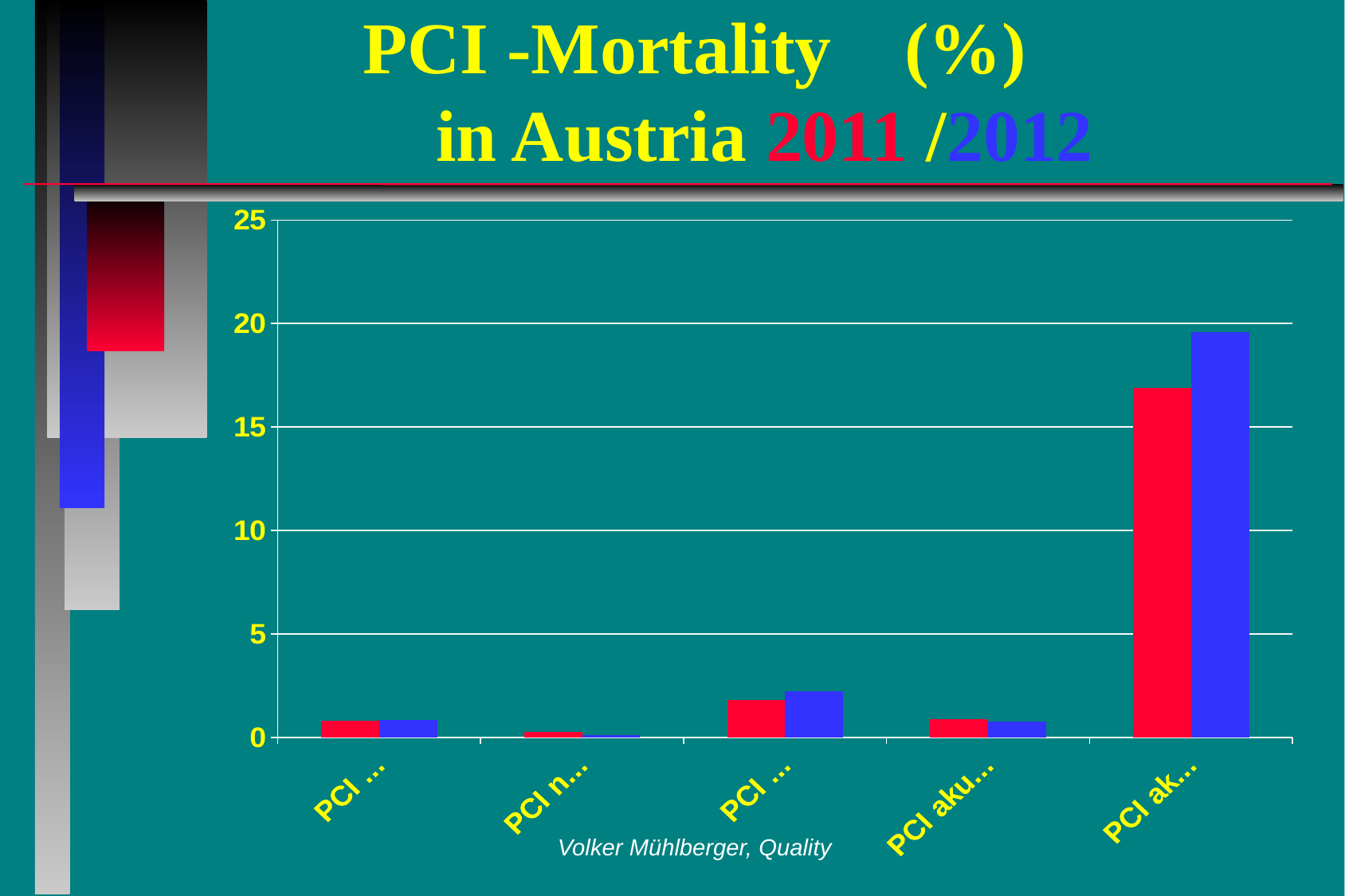
In the rightmost category group, is the red (2011) bar greater or less than 15? greater In the rightmost category group, which bar is taller, the red (2011) bar or the blue (2012) bar? the blue (2012) bar Which category group has the lowest bars in the chart? the second category from the left According to the slide title, which colour represents the year 2012? blue What is the highest value shown on the y axis of the chart? 25 In the third category group from the left, is the blue (2012) bar greater or less than 5? less In the rightmost category group, is the blue (2012) bar greater or less than 20? less How many categories are shown along the x axis of the chart? 5 Which category group has the tallest bars in the chart? the rightmost category (fifth group) What kind of chart is shown on the slide? bar chart